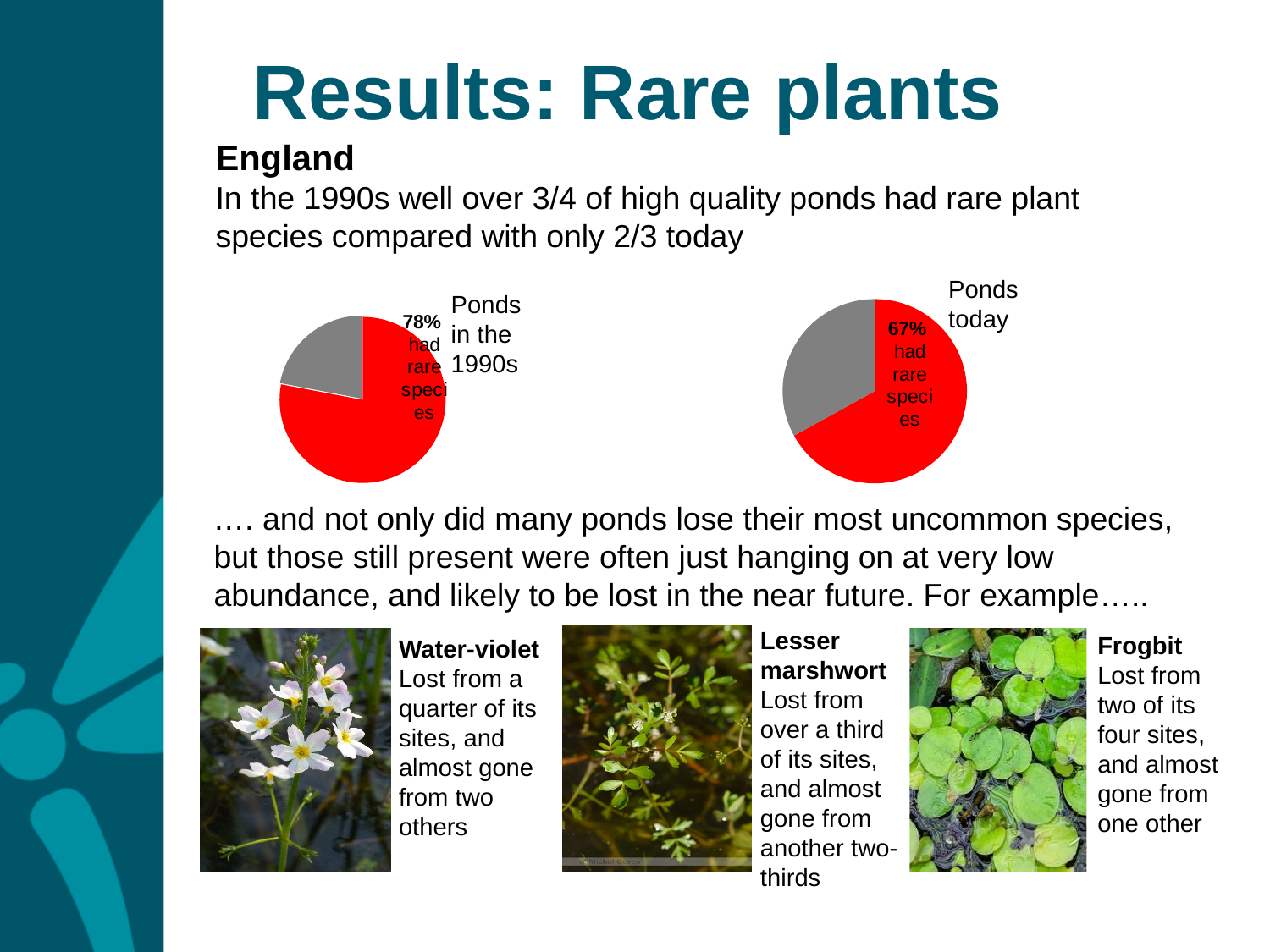
What type of chart is used to show the ponds with rare species in the 1990s? Pie chart In the 'Ponds in the 1990s' pie chart, what percentage of ponds had rare species? 78% Which chart shows a larger share of ponds with rare species, 'Ponds in the 1990s' or 'Ponds today'? Ponds in the 1990s In the 'Ponds today' pie chart, what share of the pie does the 'had rare species' slice represent? 67% In the 'Ponds today' pie chart, what percentage of ponds had rare species? 67% How many slices does the 'Ponds in the 1990s' pie chart have? 2 What type of chart is the 'Ponds today' chart? Pie chart What is the title of the pie chart on the left of the slide? Ponds in the 1990s By how many percentage points did the share of ponds with rare species fall between the 'Ponds in the 1990s' chart and the 'Ponds today' chart? 11 percentage points In the 'Ponds in the 1990s' pie chart, what share of the pie does the 'had rare species' slice represent? 78% How many slices does the 'Ponds today' pie chart have? 2 What colour is the 'had rare species' slice in the 'Ponds today' pie chart? Red